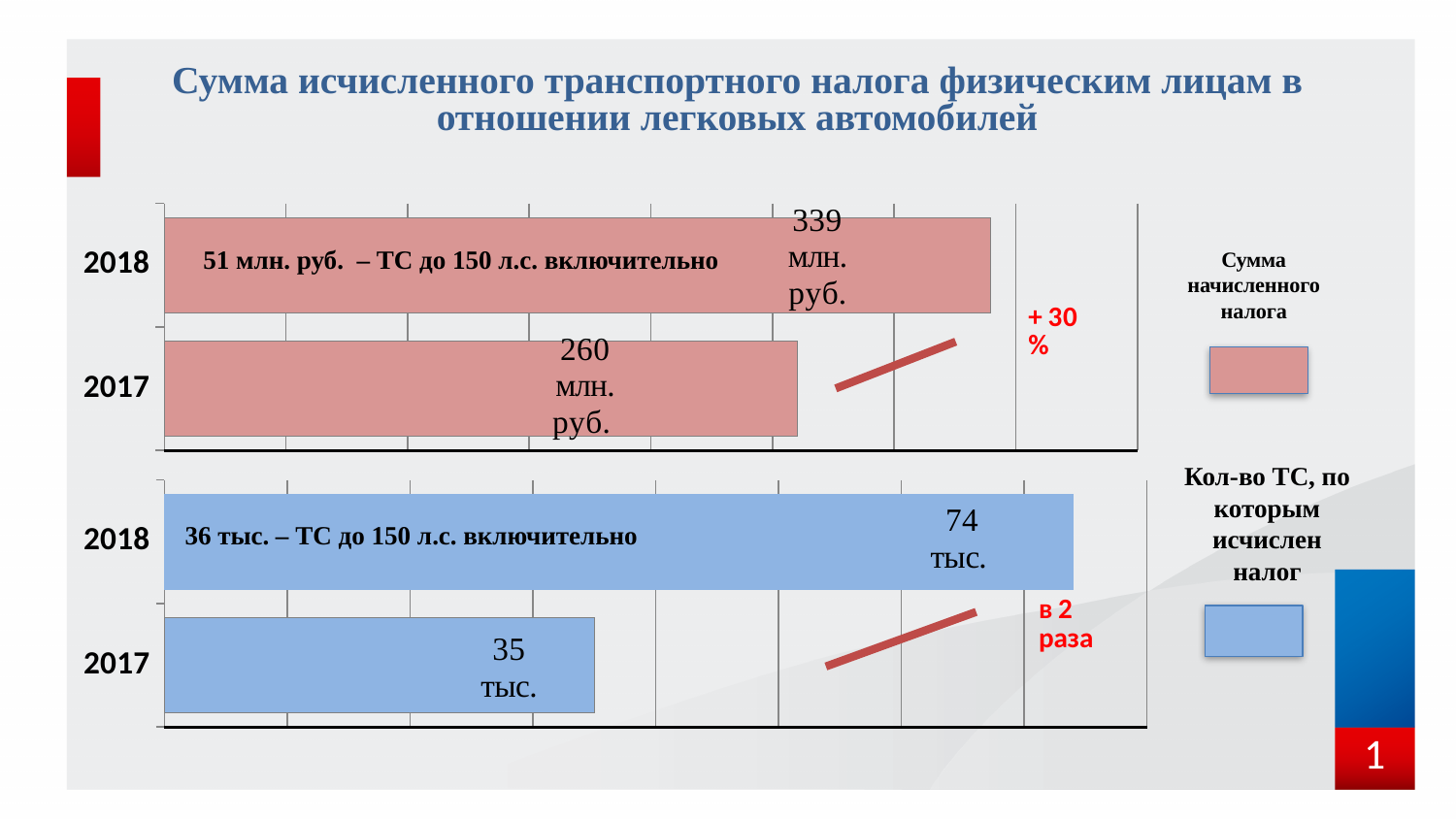
In the top chart (Сумма начисленного налога), what is the value for 2018? 339 млн. руб. In the top chart (Сумма начисленного налога), what is the value for 2017? 260 млн. руб. In the top chart (Сумма начисленного налога), by how much does the 2018 value exceed the 2017 value? 79 млн. руб. In the bottom chart (Кол-во ТС, по которым исчислен налог), what is the value for 2018? 74 тыс. In the top chart (Сумма начисленного налога), which year has the higher value? 2018 In the bottom chart (Кол-во ТС, по которым исчислен налог), what is the difference between the 2018 and 2017 values? 39 тыс. How many years (categories) are shown in the top chart (Сумма начисленного налога)? 2 In the bottom chart (Кол-во ТС, по которым исчислен налог), which year has the lower value? 2017 What type of chart is the bottom chart (Кол-во ТС, по которым исчислен налог)? bar chart What percentage growth is annotated in red on the top chart (Сумма начисленного налога)? + 30 % In the bottom chart (Кол-во ТС, по которым исчислен налог), what is the value for 2017? 35 тыс. In the bottom chart (Кол-во ТС, по которым исчислен налог), is the value for 2018 larger or smaller than the value for 2017? larger